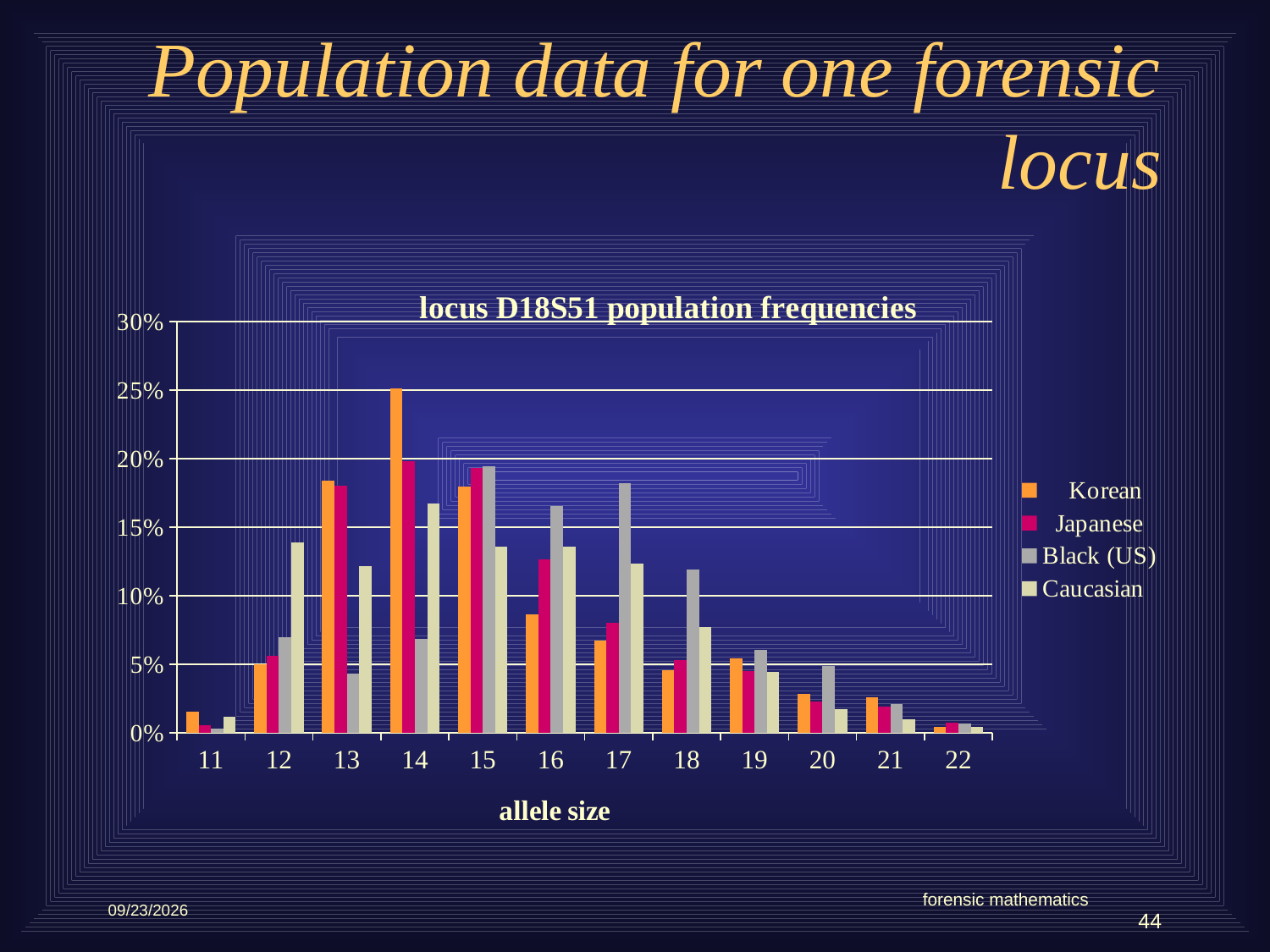
At which allele size is the Korean value lowest? 22 Is the Korean value at allele size 14 greater or less than 20%? greater At allele size 17, which is larger: the Black (US) value or the Korean value? Black (US) How many series does the legend list? 4 Is the Black (US) value at allele size 17 greater or less than 15%? greater Do the Korean values rise or fall from allele size 14 to allele size 22? fall At which allele size is the Korean value highest? 14 How many allele size categories are shown on the x axis? 12 What kind of chart is shown on the slide? bar chart What is the title of the chart? locus D18S51 population frequencies What is the label of the x axis? allele size Is the Caucasian value at allele size 12 greater or less than 15%? less